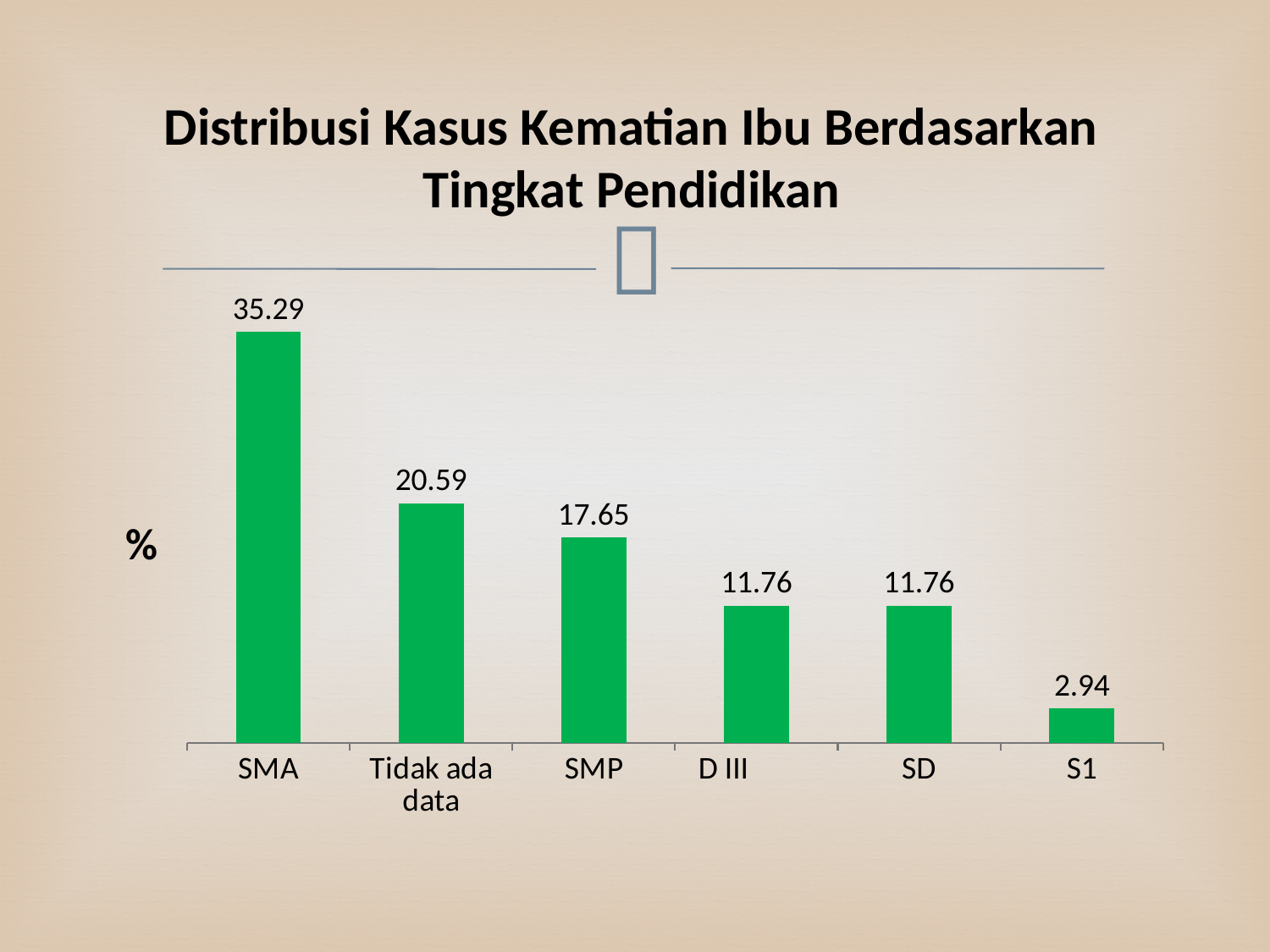
What kind of chart is shown on the slide? Bar chart What is the difference between the values for SMA and Tidak ada data? 14.7 What is the value for SMP? 17.65 What is the value for Tidak ada data? 20.59 What is the title of the chart? Distribusi Kasus Kematian Ibu Berdasarkan Tingkat Pendidikan What is the value for S1? 2.94 What is the difference between the values for SMP and S1? 14.71 Which is larger, the value for SMP or the value for SD? SMP Which category has the highest value? SMA What is the value for SMA? 35.29 How many categories are shown on the x axis? 6 Which category has the lowest value? S1